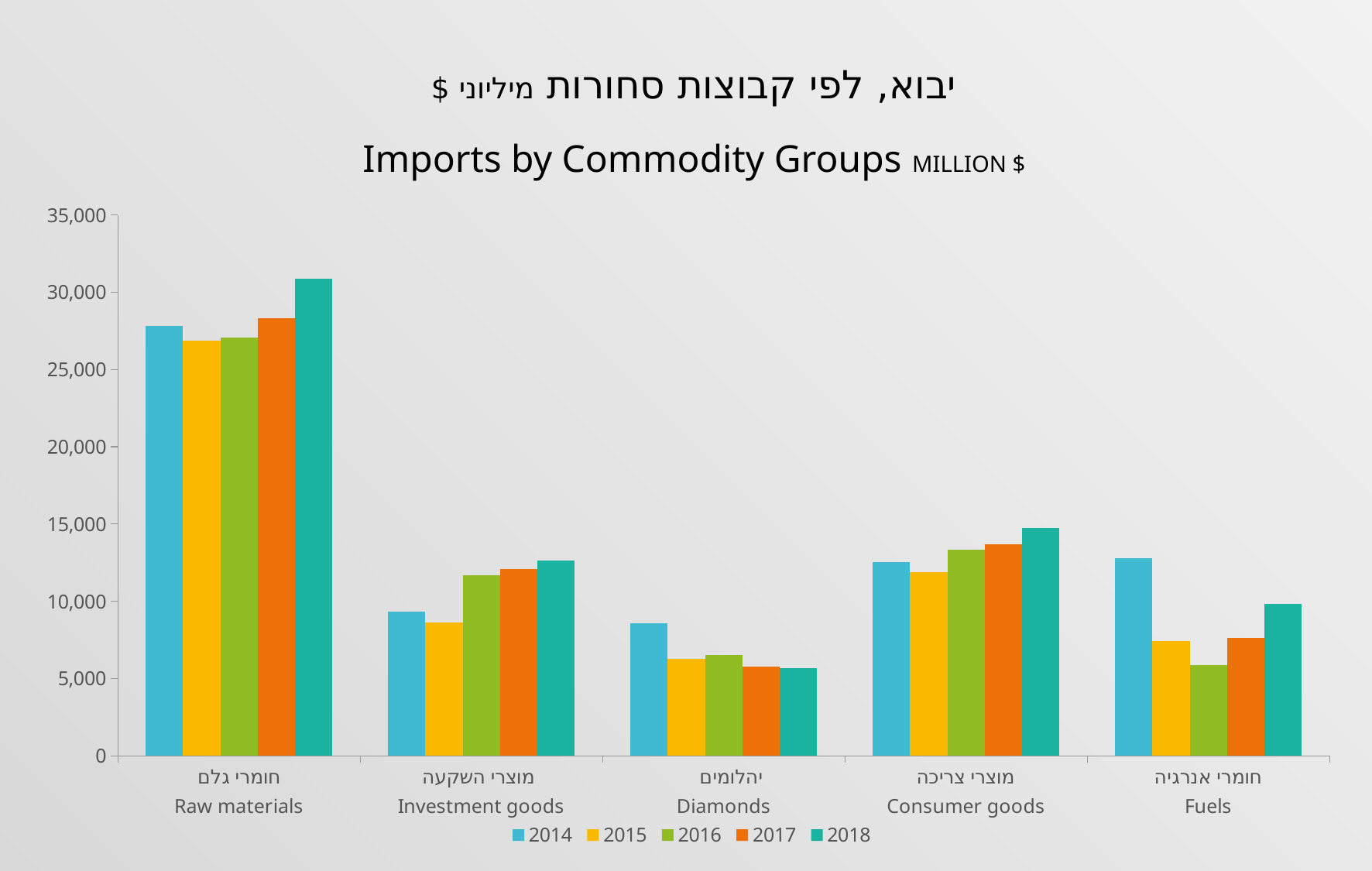
Is the value for Diamonds in 2014 greater or less than 10,000? less Which is larger in 2018: Consumer goods or Fuels? Consumer goods How many series does the legend list? 5 What kind of chart is shown on the slide? Bar chart Do the Investment goods values rise or fall from 2015 to 2018? rise Is the value for Raw materials in 2018 greater or less than 30,000? greater Which commodity group has the highest imports in 2018? Raw materials How many commodity groups are shown on the x axis? 5 What is the English title of the chart? Imports by Commodity Groups Which commodity group has the lowest imports in 2018? Diamonds What unit is stated next to the chart title? MILLION $